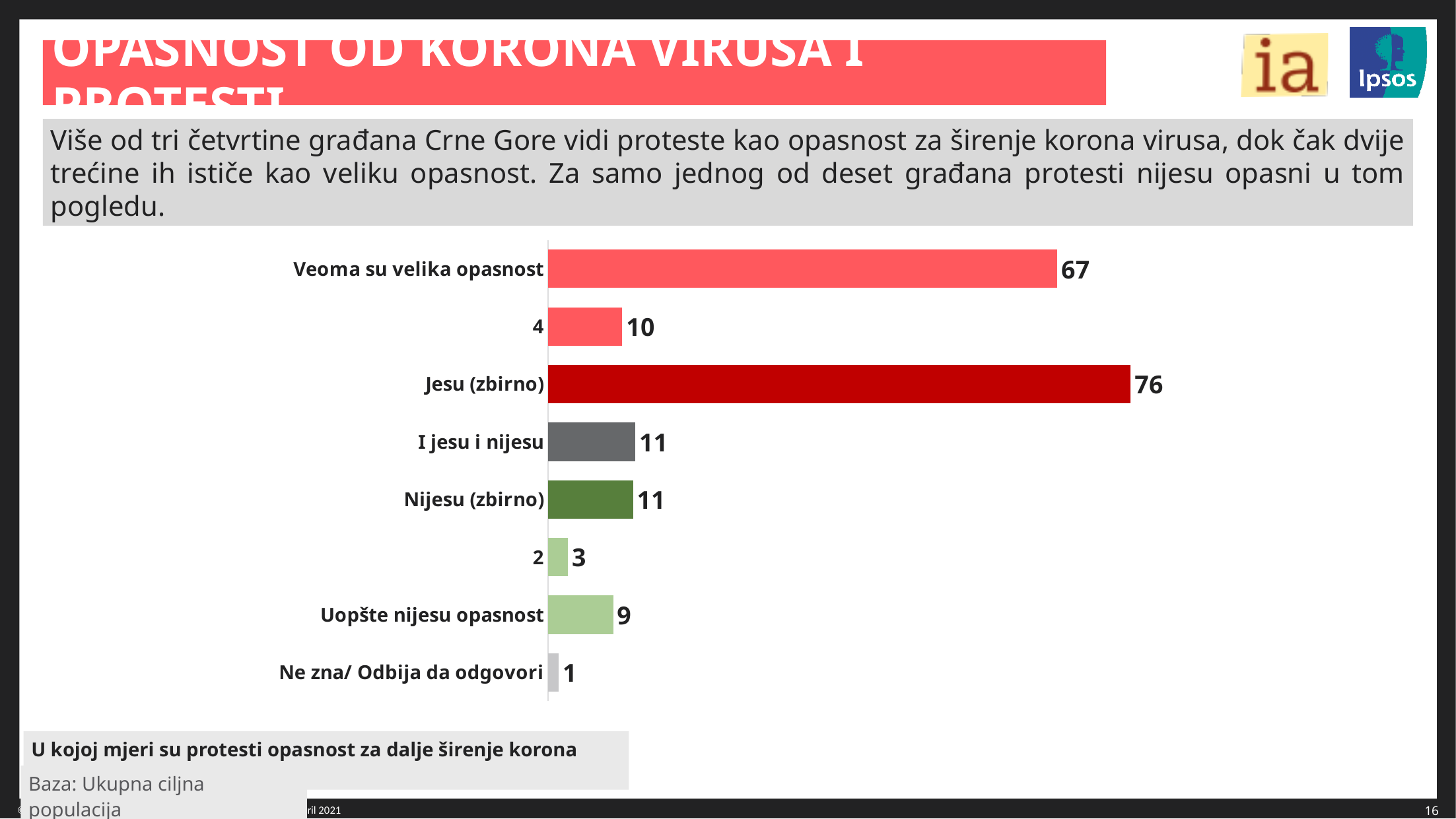
What is the difference between the values for "Jesu (zbirno)" and "Nijesu (zbirno)"? 65 Which category has the lowest value? Ne zna/ Odbija da odgovori What colour is the bar for "Jesu (zbirno)"? dark red What kind of chart is shown on the slide? bar chart What is the value for "Ne zna/ Odbija da odgovori"? 1 How many categories (bars) does the chart show? 8 What is the value for "I jesu i nijesu"? 11 What is the value for "Veoma su velika opasnost"? 67 Which is larger, the value for "Uopšte nijesu opasnost" or the value for the category labelled "2"? Uopšte nijesu opasnost Which category has the highest value? Jesu (zbirno) What is the value for "Jesu (zbirno)"? 76 What is the value for "Uopšte nijesu opasnost"? 9